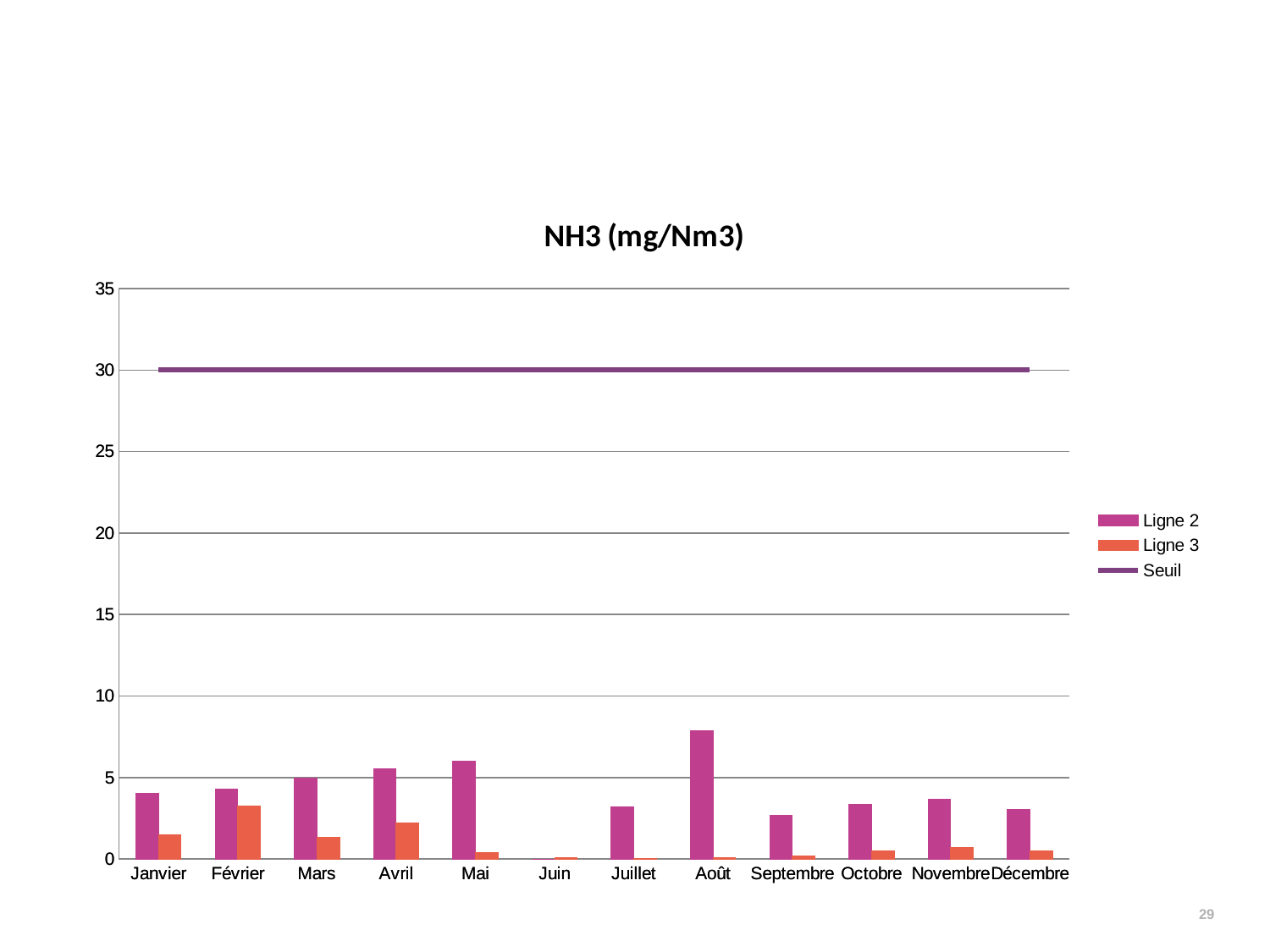
At what value is the Seuil line drawn? 30 In which month is the Ligne 2 value highest? Août Is the Ligne 3 value for Avril greater or less than 5? less Is the Ligne 2 value for Août greater or less than 5? greater In which month is the Ligne 2 value lowest? Juin Is the Ligne 2 value for Janvier greater or less than 5? less In which month is the Ligne 3 value highest? Février How many months are shown on the x axis? 12 In Février, which series has the larger value, Ligne 2 or Ligne 3? Ligne 2 How many series does the legend list? 3 What is the title of the chart? NH3 (mg/Nm3) What type of chart is shown on the slide? combination bar and line chart